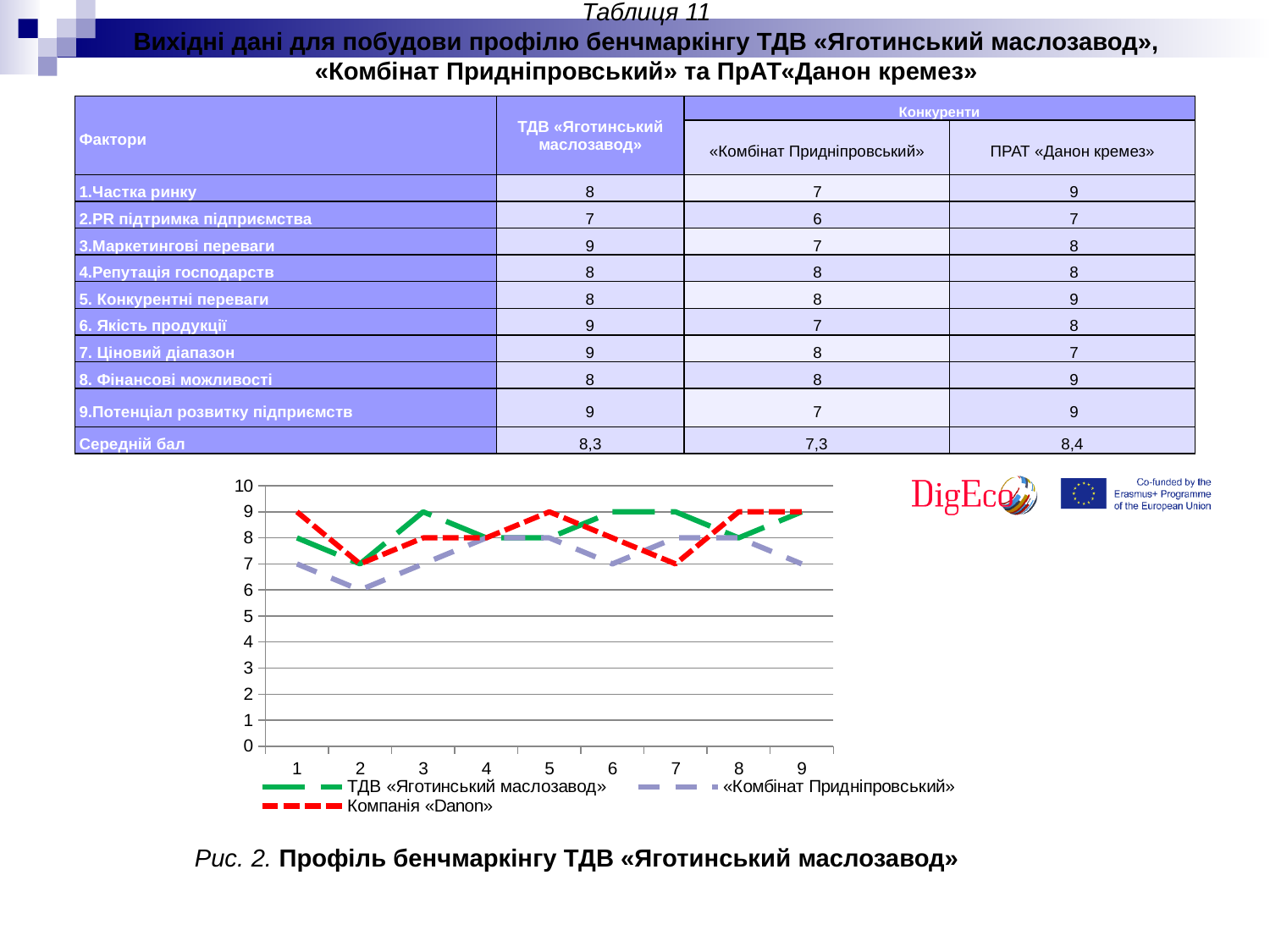
At which point does «Комбінат Придніпровський» reach its lowest value on the chart? 2 What is the value of ТДВ «Яготинський маслозавод» at point 3 on the chart? 9 At point 2, what is the difference between ТДВ «Яготинський маслозавод» and «Комбінат Придніпровський»? 1 What is the value of «Комбінат Придніпровський» at point 2 on the chart? 6 Is the value for «Комбінат Придніпровський» at point 2 greater or less than 7? less Does the Компанія «Danon» line rise or fall from point 7 to point 8? rise How many points are plotted along the x axis of the chart? 9 How many series does the chart legend list? 3 Which series is drawn with the green dashed line on the chart? ТДВ «Яготинський маслозавод» What type of chart is shown below the table? line chart At point 1, which series has the larger value: Компанія «Danon» or ТДВ «Яготинський маслозавод»? Компанія «Danon» What is the value of Компанія «Danon» at point 7 on the chart? 7